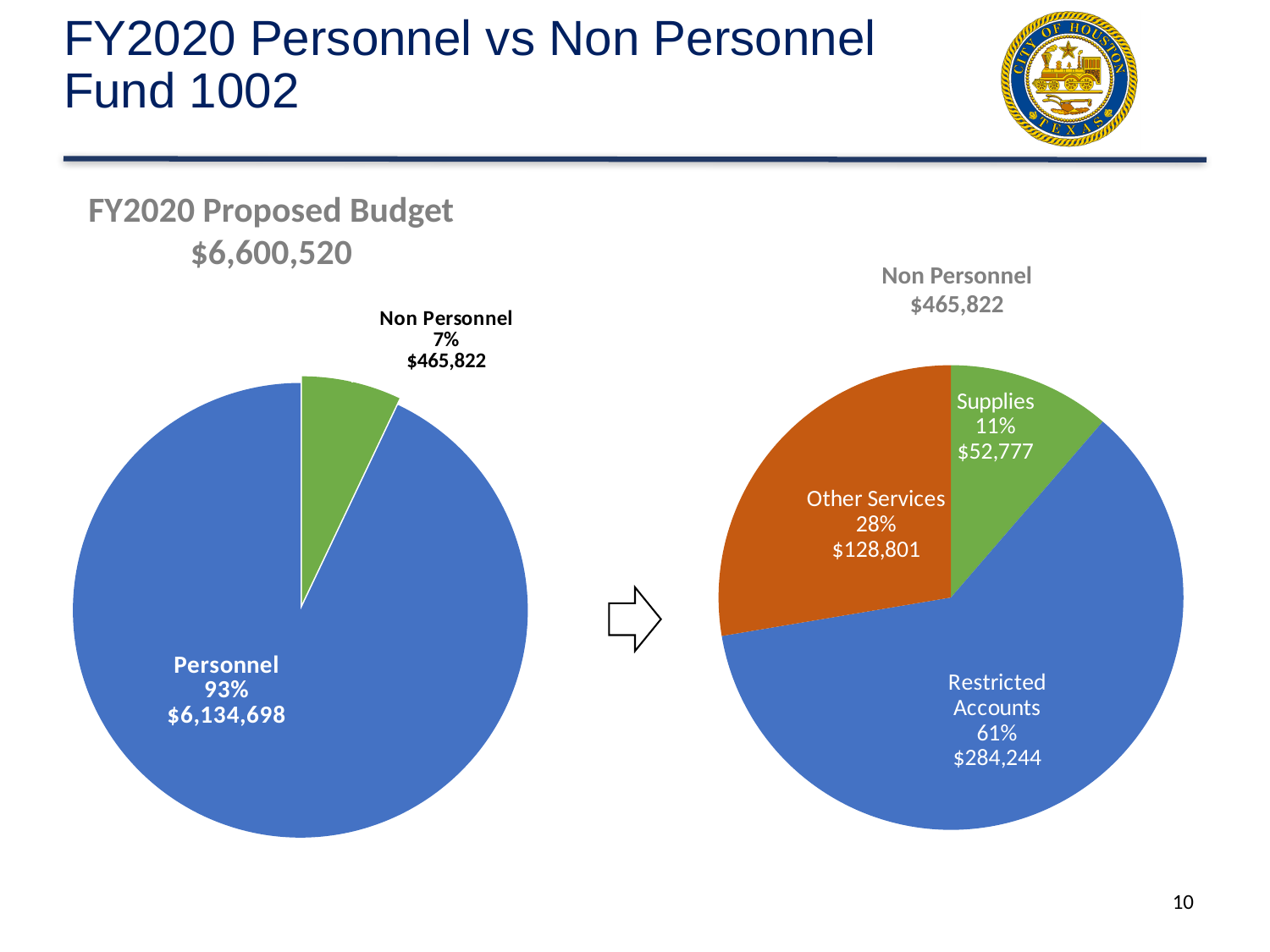
In the left pie chart (FY2020 Proposed Budget), what share of the pie is Non Personnel? 7% In the right pie chart (Non Personnel), what share of the pie is Restricted Accounts? 61% In the right pie chart (Non Personnel), which is larger, Other Services or Supplies? Other Services In the right pie chart (Non Personnel), what is the difference between Restricted Accounts and Supplies? $231,467 In the right pie chart (Non Personnel), which category is the largest? Restricted Accounts In the right pie chart (Non Personnel), which category is the smallest? Supplies In the left pie chart (FY2020 Proposed Budget), what is the value for Personnel? $6,134,698 What kind of chart is the left chart (FY2020 Proposed Budget)? Pie chart What is the title of the right chart? Non Personnel $465,822 In the left pie chart (FY2020 Proposed Budget), what is the value for Non Personnel? $465,822 In the right pie chart (Non Personnel), what is the value for Other Services? $128,801 How many slices does the right pie chart (Non Personnel) have? 3